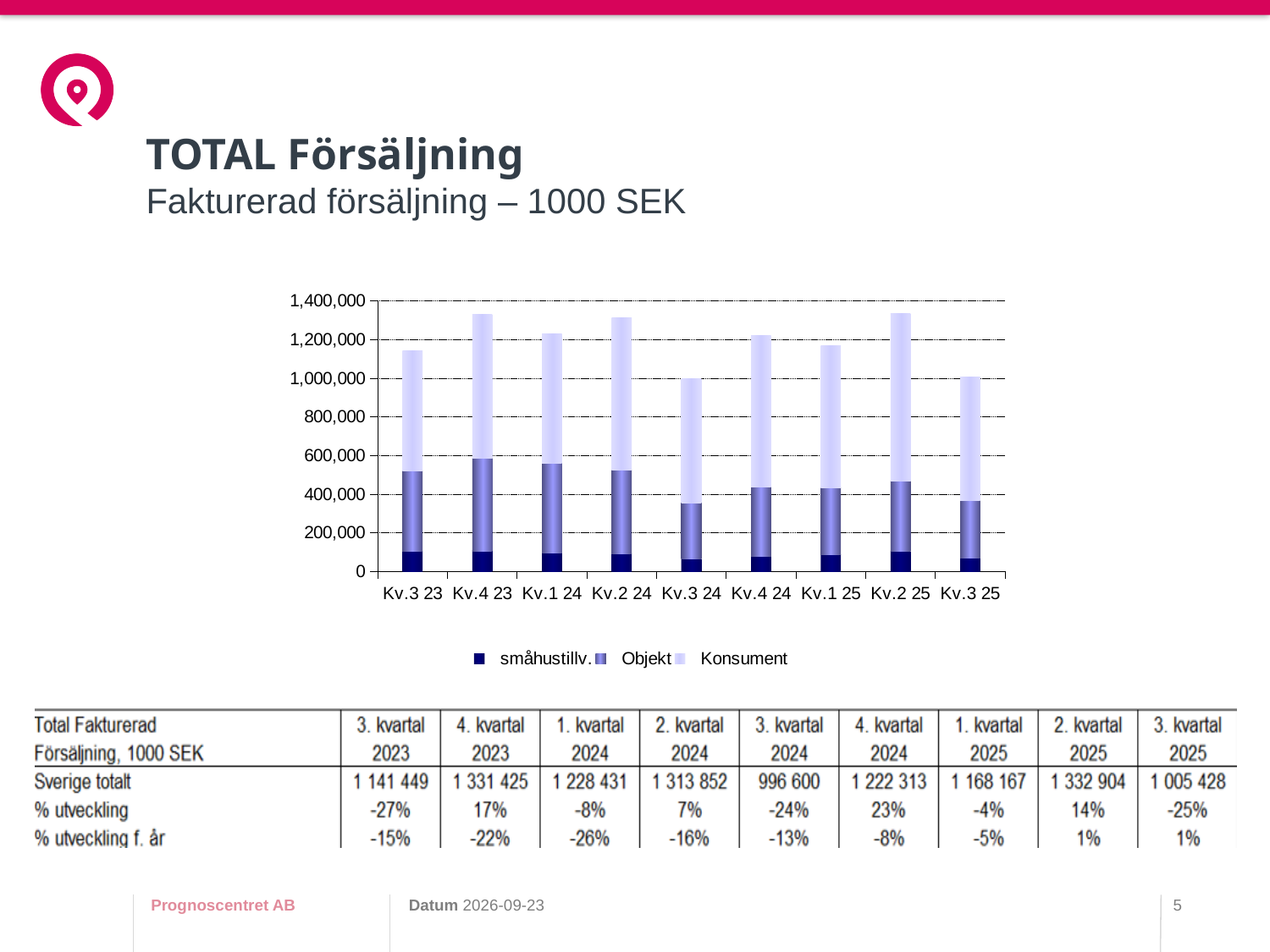
Which series forms the top (lightest) segment of each stacked bar? Konsument Is the total stacked bar for Kv.3 25 greater or less than 1,200,000? less Is the total stacked bar for Kv.3 23 greater or less than 1,000,000? greater What are the three series named in the chart legend? småhustillv., Objekt, Konsument How many series does the chart legend list? 3 Is the total stacked bar for Kv.4 23 greater or less than 1,200,000? greater According to the table, what is the total invoiced sales (Sverige totalt) for 3. kvartal 2023, i.e. the total of the Kv.3 23 stacked bar? 1 141 449 Does the total stacked bar rise or fall from Kv.2 24 to Kv.3 24? fall Which stacked bar is taller, Kv.2 24 or Kv.3 24? Kv.2 24 What kind of chart is shown on the slide? Stacked bar chart Which stacked bar is taller, Kv.3 23 or Kv.4 23? Kv.4 23 How many quarters are shown along the x axis of the chart? 9